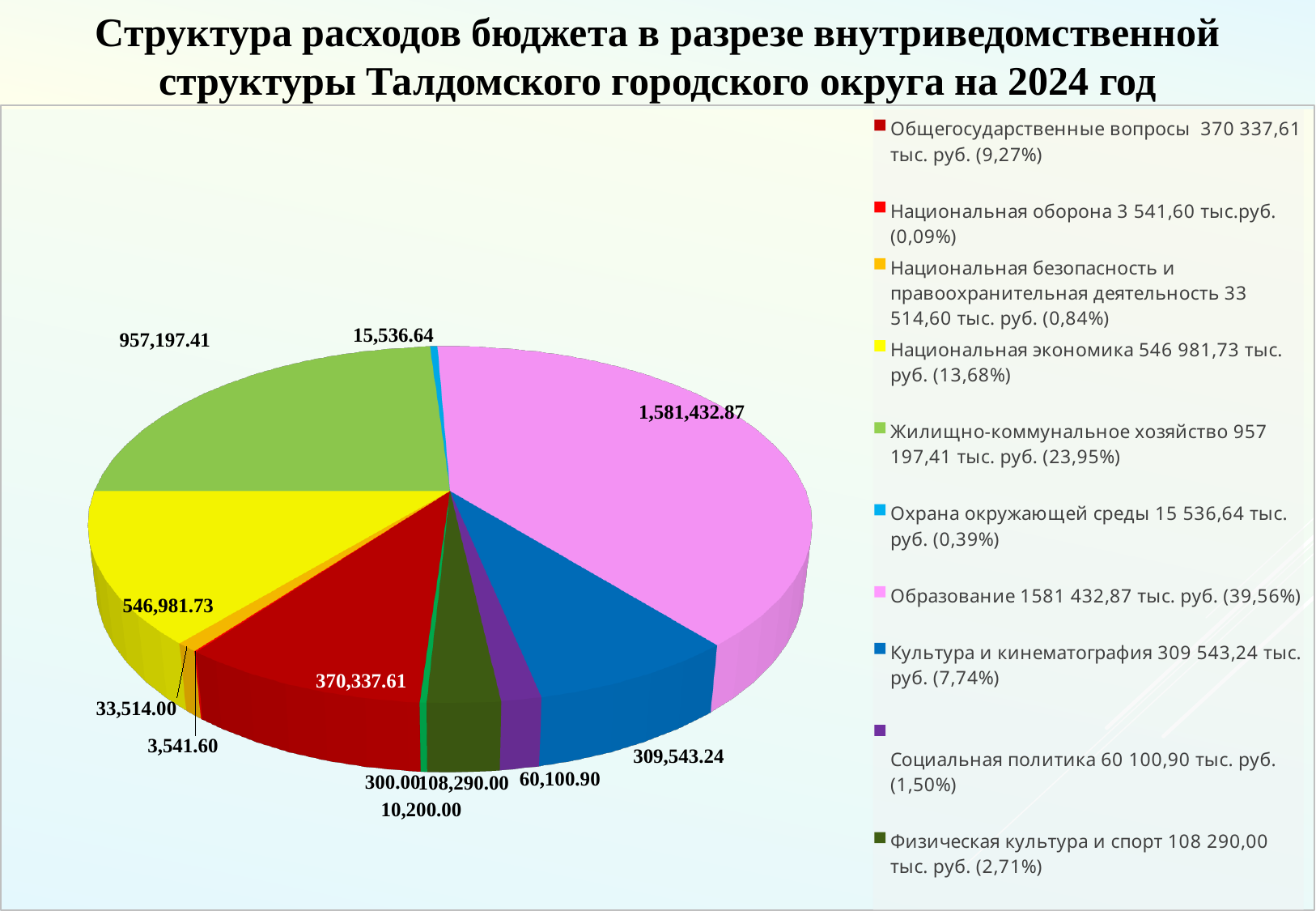
What colour is the Образование slice? pink What is the difference between the Национальная экономика slice (546,981.73) and the Общегосударственные вопросы slice (370,337.61)? 176,644.12 What value is labelled on the Жилищно-коммунальное хозяйство slice? 957,197.41 What kind of chart is shown on the slide? pie chart According to the legend, what share of the budget does Национальная оборона account for? 0,09% What value is labelled on the Образование slice of the pie chart? 1,581,432.87 According to the legend, what share of the budget does Образование account for? 39,56% How many entries does the legend list? 10 What is the difference between the Образование slice (1,581,432.87) and the Жилищно-коммунальное хозяйство slice (957,197.41)? 624,235.46 Which category has the largest slice of the pie? Образование What value is labelled on the Культура и кинематография slice? 309,543.24 Which is larger: the Национальная экономика slice or the Общегосударственные вопросы slice? Национальная экономика